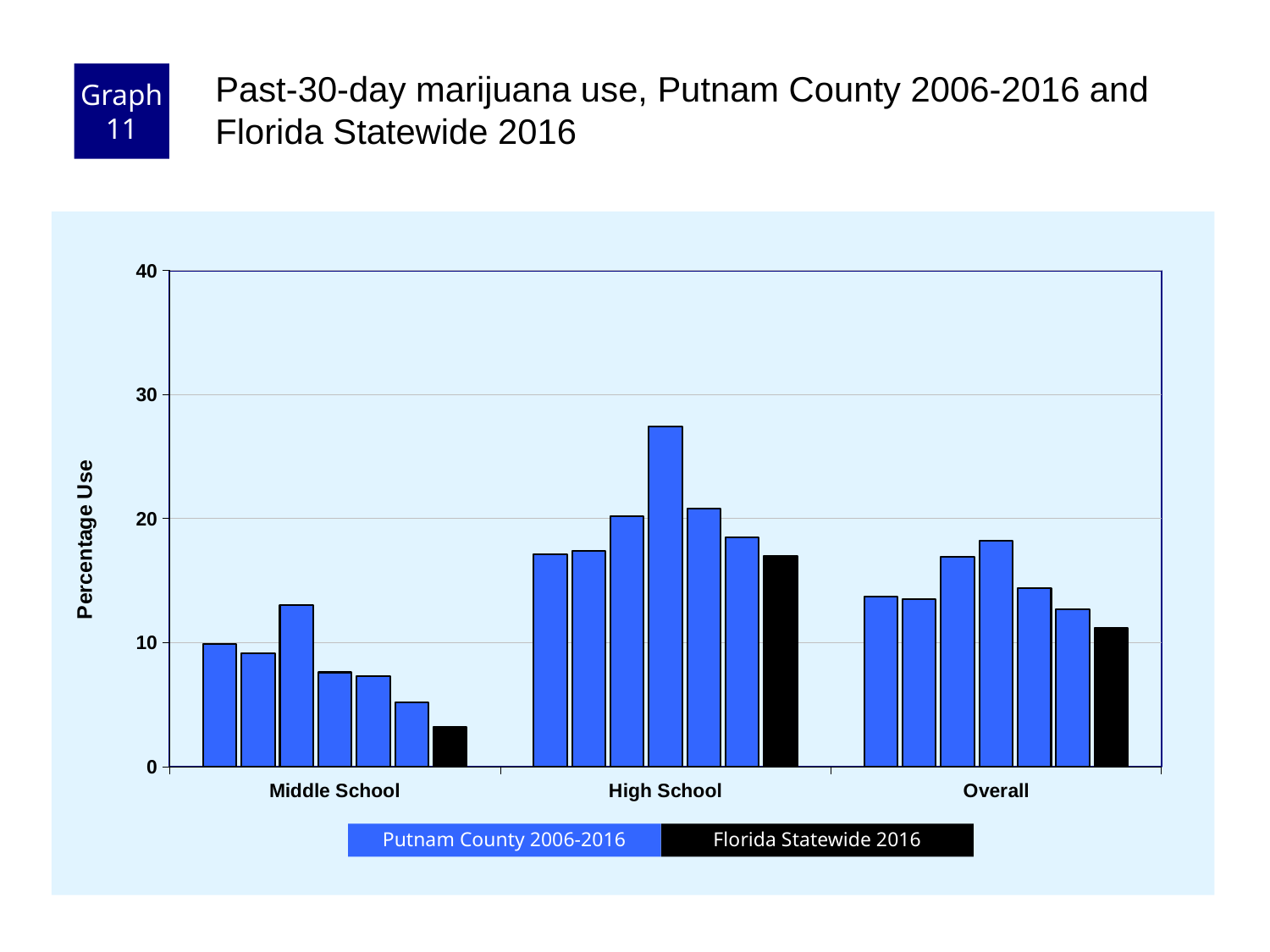
Which series is shown in black in the legend? Florida Statewide 2016 Is the Florida Statewide 2016 value for Middle School greater or less than 10? less Is the Florida Statewide 2016 value for High School greater or less than 10? greater How many school-level categories are shown on the x axis? 3 Which category has the highest bars overall? High School Is the tallest Putnam County bar in the High School group greater or less than 30? less What is the label on the y axis? Percentage Use In the Middle School group, is the last Putnam County bar higher or lower than the first Putnam County bar? lower What kind of chart is shown on the slide? bar chart Is the Florida Statewide 2016 value larger for High School or for Middle School? High School Which category has the lowest bars overall? Middle School How many series does the legend list? 2